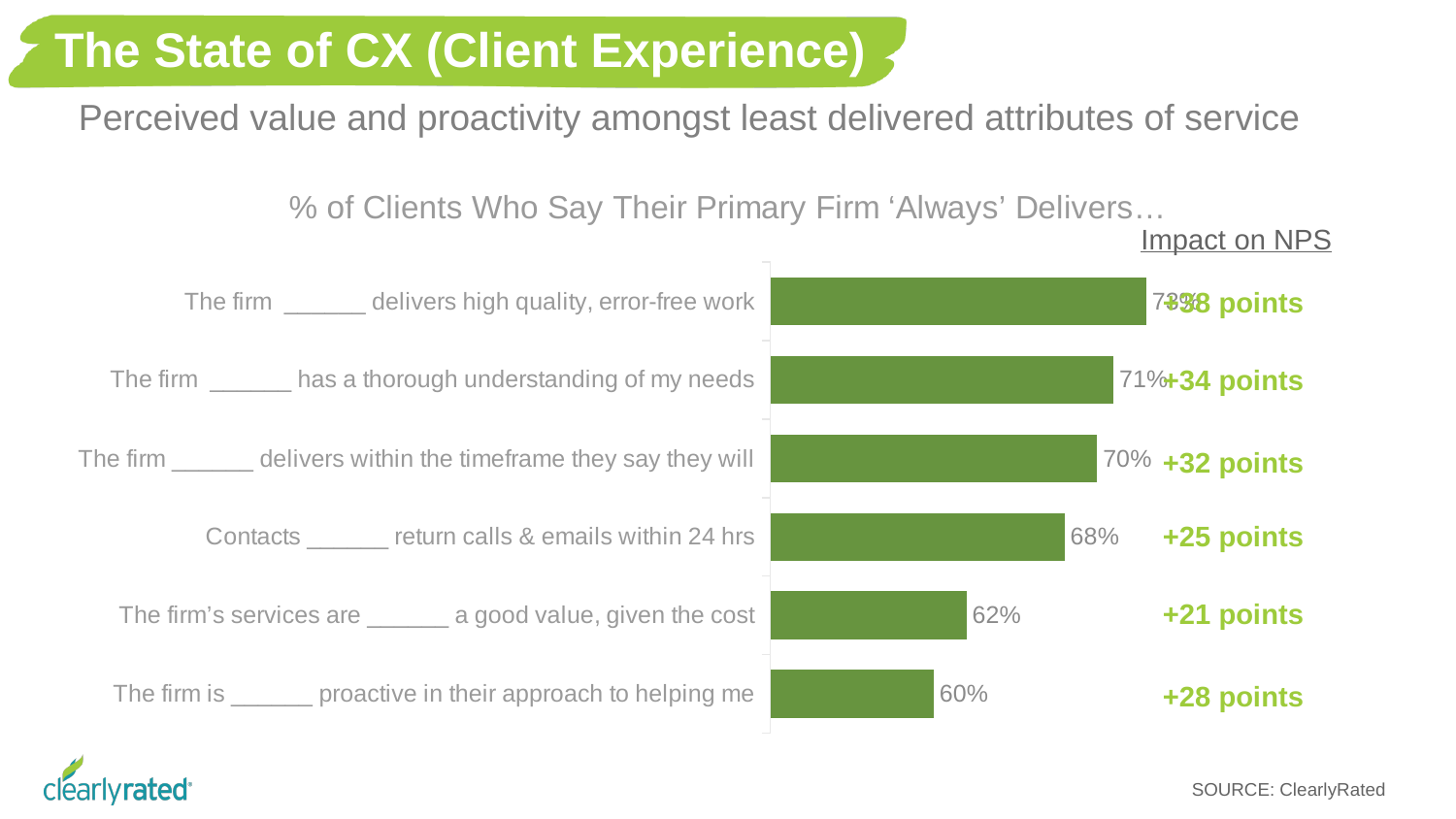
What is the value for 'The firm ______ delivers within the timeframe they say they will'? 70% Which is larger: the value for delivering within the stated timeframe or the value for services being a good value given the cost? Delivering within the stated timeframe What is the difference between the value for returning calls & emails within 24 hrs and the value for services being a good value? 6 percentage points What percentage of clients say their primary firm always has a thorough understanding of their needs? 71% What is the value for 'The firm's services are ______ a good value, given the cost'? 62% What percentage of clients say contacts always return calls & emails within 24 hrs? 68% What is the difference between the value for thorough understanding of my needs and the value for being proactive? 11 percentage points What type of chart is shown on the slide? Bar chart How many attributes are shown in the chart? 6 Which attribute has the highest percentage of clients saying their firm 'always' delivers it? The firm ______ delivers high quality, error-free work What percentage of clients say the firm is always proactive in their approach to helping them? 60% Which attribute has the lowest percentage of clients saying their firm 'always' delivers it? The firm is ______ proactive in their approach to helping me